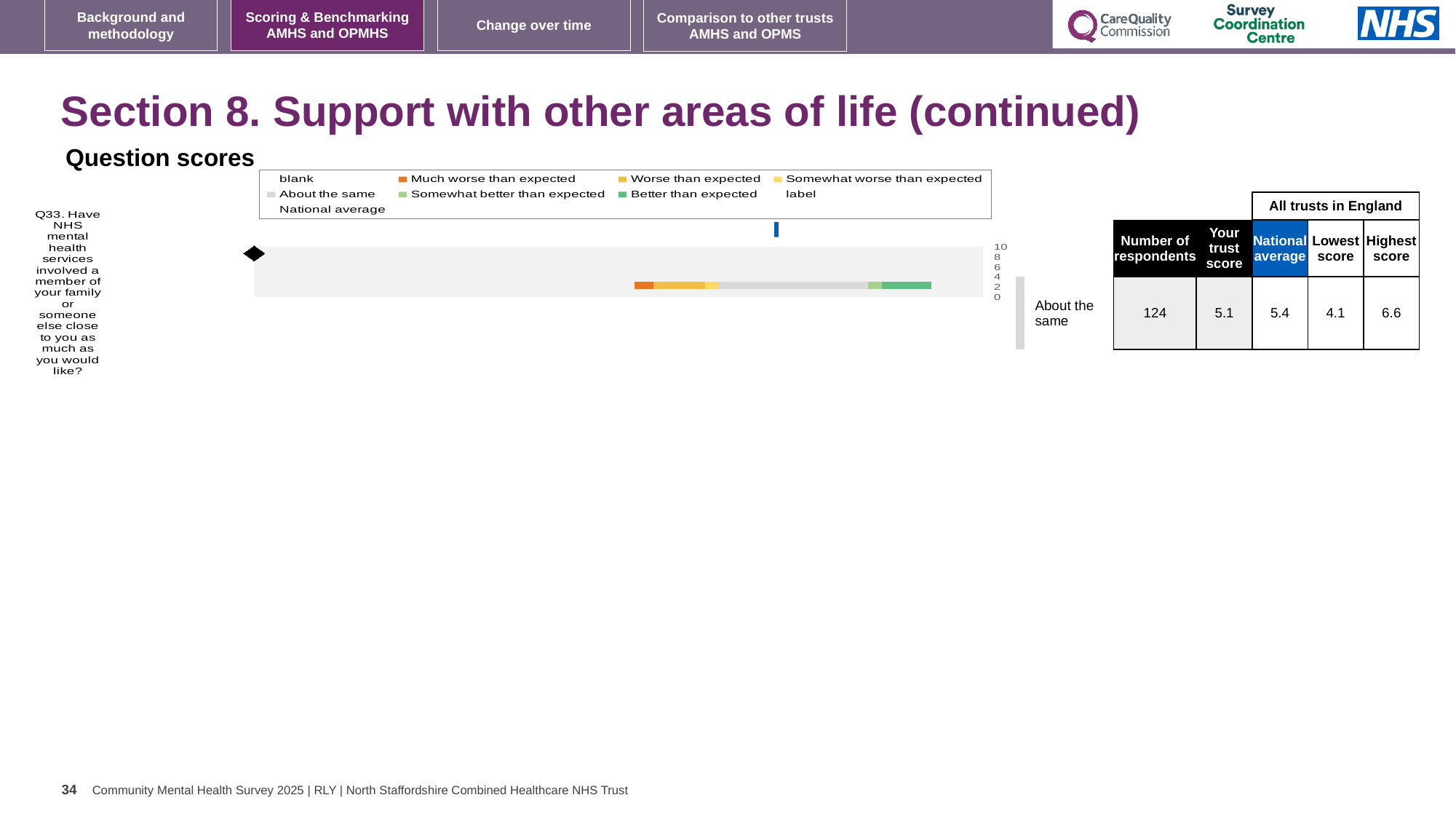
What is the highest score among all trusts in England for Q33? 6.6 What is the number of respondents for Q33 shown alongside the Question scores chart? 124 What is the lowest score among all trusts in England for Q33? 4.1 For Q33, what is the difference between the highest and lowest scores among all trusts in England? 2.5 Which benchmark category is Q33 assigned to in the Question scores chart? About the same For Q33, which is larger: the trust score or the national average? national average What is the national average for Q33 shown alongside the Question scores chart? 5.4 How many entries does the legend of the Question scores chart list? 9 What kind of chart is shown under 'Question scores'? bar chart What is the trust score for Q33 shown alongside the Question scores chart? 5.1 For Q33, what is the difference between the national average and the trust score? 0.3 How many questions are plotted in the Question scores chart? 1